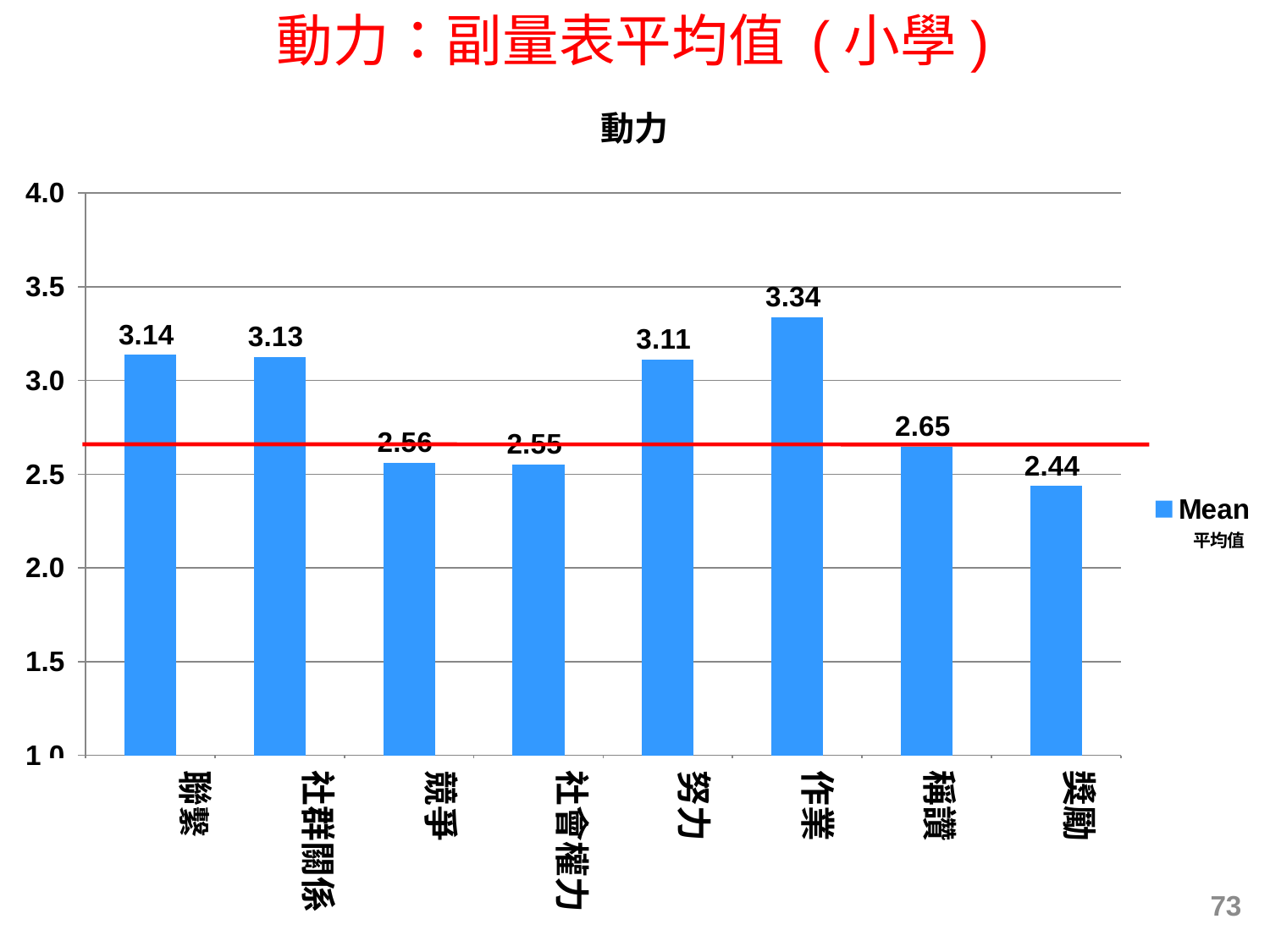
What is the value for 作業? 3.34 Which category has the highest value? 作業 What series name does the legend show? Mean How many categories are shown on the x axis? 8 What kind of chart is this? bar chart What is the value for 獎勵? 2.44 What is the difference between the values for 作業 and 獎勵? 0.90 Which is larger, the value for 努力 or the value for 稱讚? 努力 What is the value for 稱讚? 2.65 Which category has the lowest value? 獎勵 What is the value for 社會權力? 2.55 Is the value for 競爭 greater or less than 3.0? less